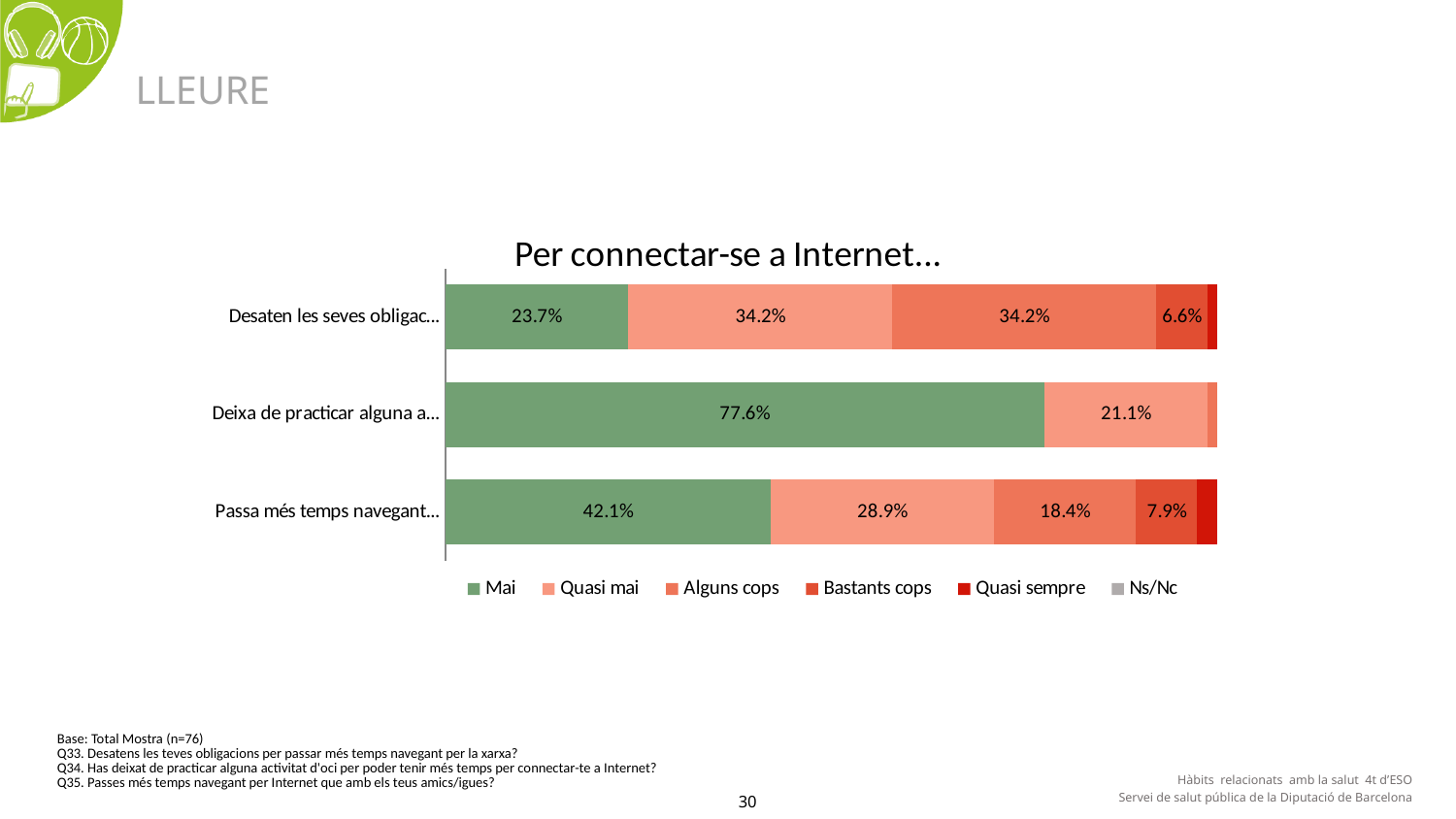
What is the 'Mai' value for 'Deixa de practicar alguna a...'? 77.6% Which category has the highest 'Mai' value? Deixa de practicar alguna a... What is the title of the chart? Per connectar-se a Internet... What is the difference between the 'Mai' values for 'Deixa de practicar alguna a...' and 'Passa més temps navegant...'? 35.5% What type of chart is shown on the slide? Stacked bar chart Which category has the lowest 'Mai' value? Desaten les seves obligac... Which is larger: the 'Quasi mai' value for 'Desaten les seves obligac...' or for 'Deixa de practicar alguna a...'? Desaten les seves obligac... What is the 'Bastants cops' value for 'Desaten les seves obligac...'? 6.6% How many series does the legend list? 6 What is the 'Alguns cops' value for 'Passa més temps navegant...'? 18.4% How many categories (bars) are shown in the chart? 3 What is the 'Quasi mai' value for 'Passa més temps navegant...'? 28.9%